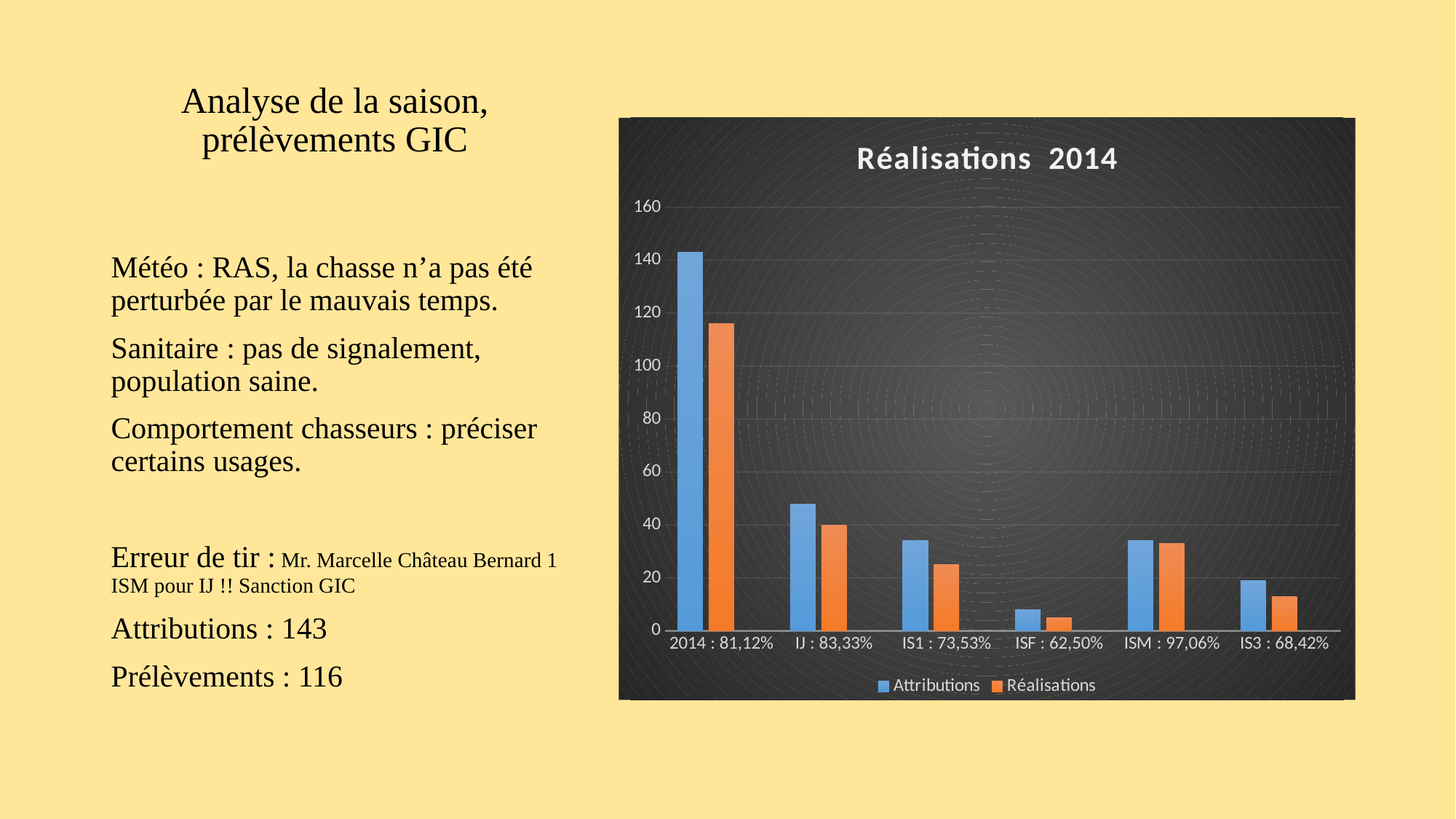
Which category has the lowest Réalisations value? ISF : 62,50% Which colour represents the Attributions series in the chart? blue What is the title of the chart? Réalisations 2014 Which is larger, the Attributions value for IJ : 83,33% or the Attributions value for IS1 : 73,53%? IJ : 83,33% Which category has the highest Attributions value? 2014 : 81,12% What kind of chart is shown on the slide? bar chart Is the Attributions value for ISF : 62,50% greater or less than 20? less Is the Réalisations value for 2014 : 81,12% greater or less than 100? greater How many categories are shown on the x axis of the chart? 6 Is the Attributions value for 2014 : 81,12% greater or less than 120? greater How many series does the chart legend list? 2